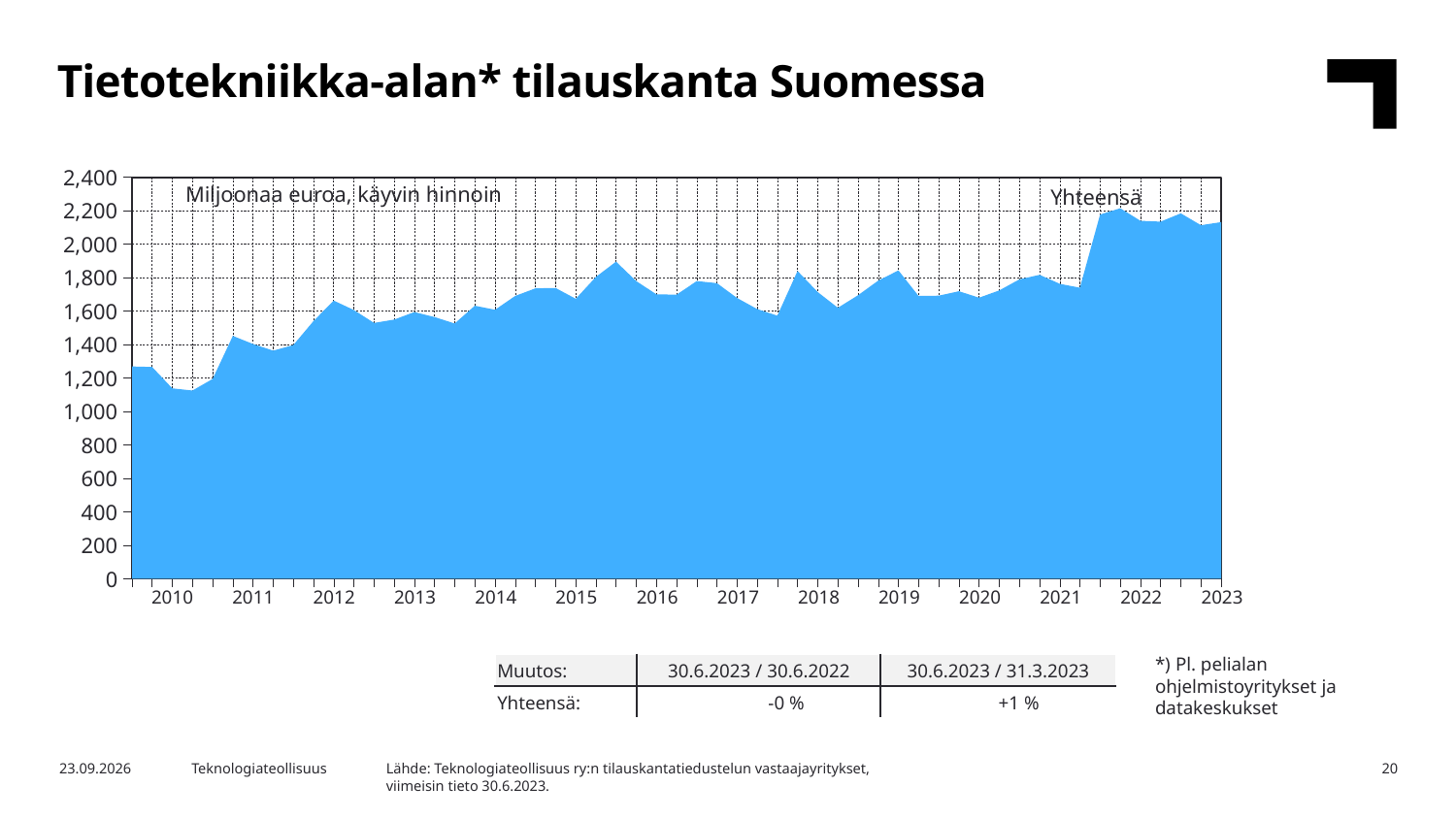
What is the title of the chart on the slide? Tietotekniikka-alan* tilauskanta Suomessa In which year on the x axis is the plotted value lowest? 2010 How many series does the chart plot? 1 Is the highest value on the chart greater or less than 2,000? greater How many year labels are shown on the x axis? 14 In what unit are the values on the chart expressed, according to the label inside the plot area? Miljoonaa euroa, käyvin hinnoin Is the value at the 2011 tick greater or less than 1,600? less Is the value at the 2015 tick greater or less than 1,600? greater What kind of chart is shown on the slide? Area chart Overall, do the values rise or fall from 2010 to 2023? Rise Which is larger, the value at the 2023 tick or the value at the 2010 tick? 2023